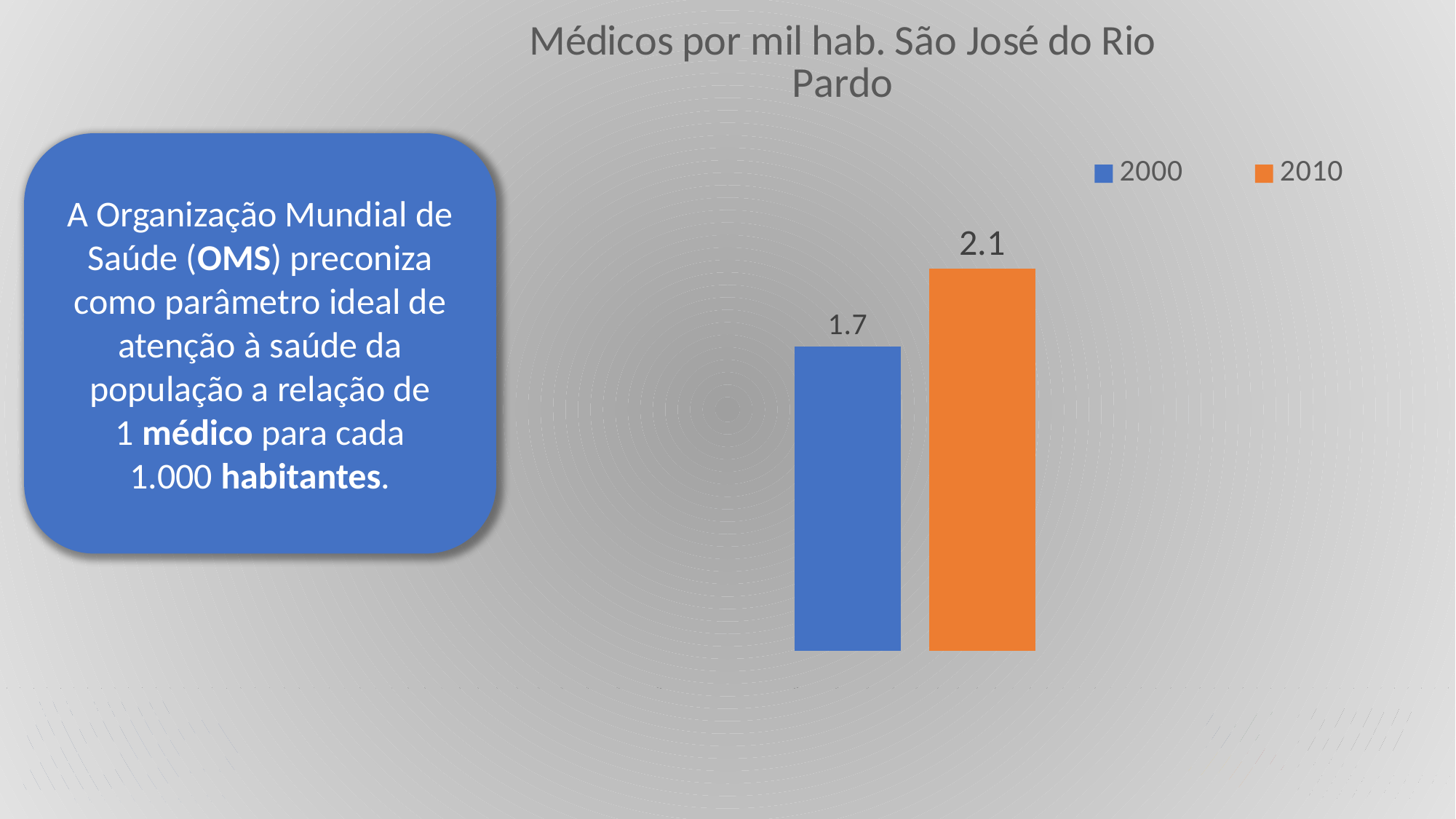
What kind of chart is shown on the slide? Bar chart What colour is the bar for 2010? Orange What is the value for 2010? 2.1 Did the number of doctors per thousand inhabitants rise or fall from 2000 to 2010? Rise Is the value for 2010 larger than the value for 2000? Yes What is the value for 2000? 1.7 Which series has the lower value, 2000 or 2010? 2000 Which series has the higher value, 2000 or 2010? 2010 How many bars are plotted in the chart? 2 How many series does the legend list? 2 What is the difference between the 2010 value and the 2000 value? 0.4 What is the title of the chart? Médicos por mil hab. São José do Rio Pardo